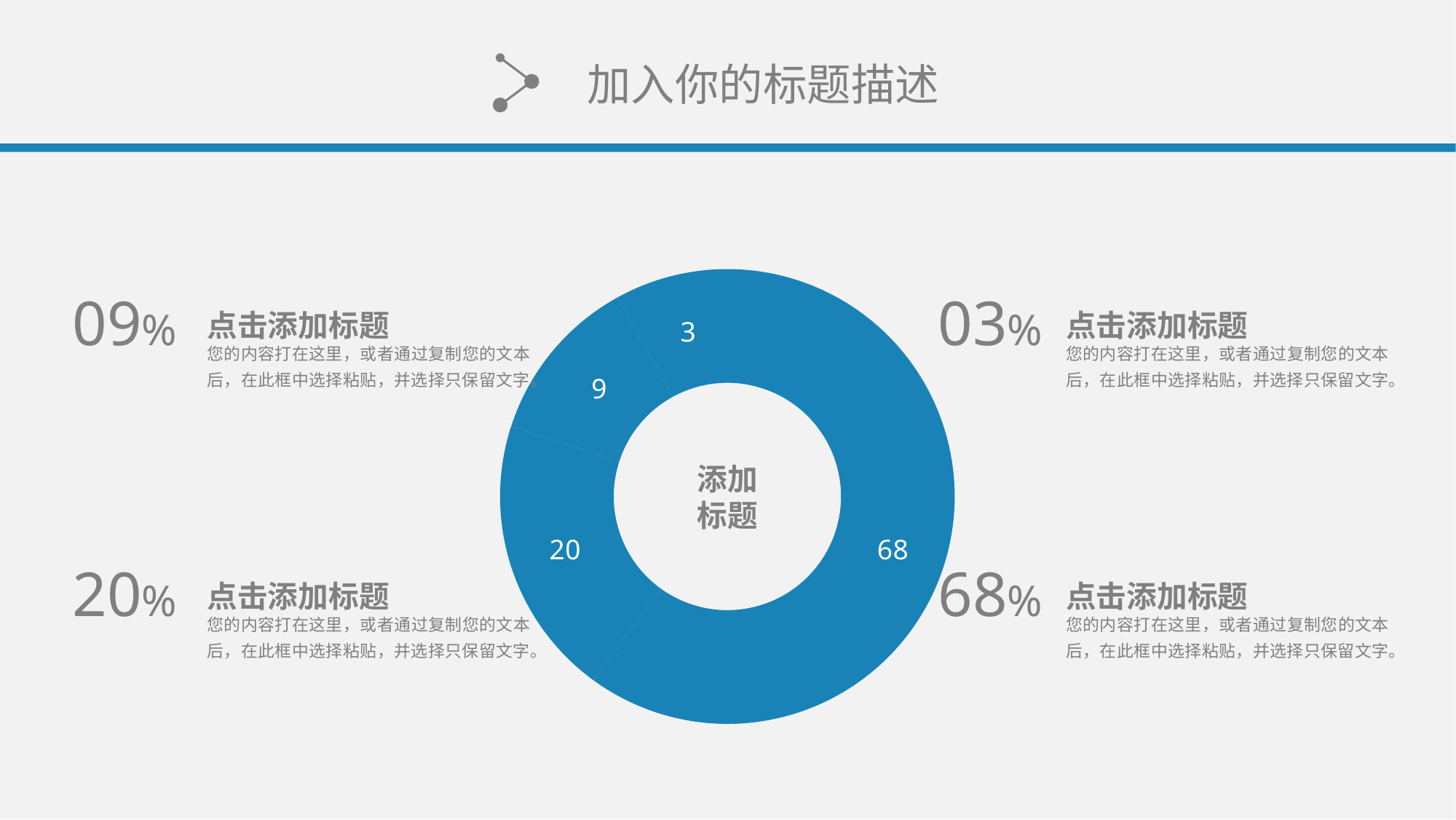
What is the difference between the slices labelled 9 and 3? 6 What text is shown in the centre of the doughnut chart? 添加标题 What kind of chart is shown on the slide? doughnut chart What is the total of all the slice values in the doughnut chart? 100 What is the largest value labelled on the doughnut chart? 68 What is the value labelled on the slice at the top of the doughnut chart? 3 What is the smallest value labelled on the doughnut chart? 3 How many slices does the doughnut chart have? 4 What is the difference between the largest slice (68) and the slice labelled 20? 48 Which slice is larger, the one labelled 9 or the one labelled 20? 20 What is the value labelled on the slice on the left side of the doughnut chart? 20